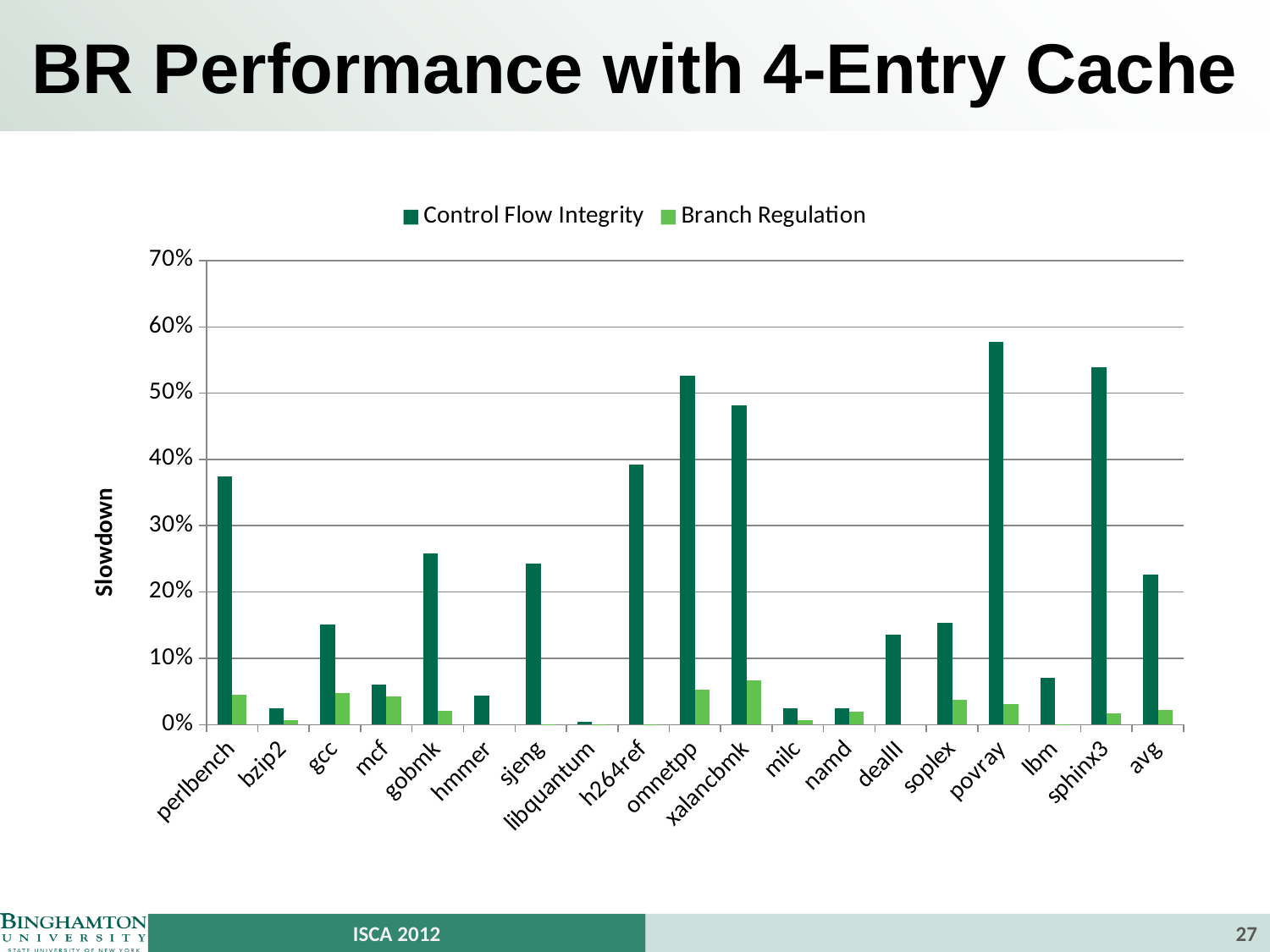
Is the Control Flow Integrity value for perlbench greater or less than 30%? greater Which is larger for omnetpp: the Control Flow Integrity slowdown or the Branch Regulation slowdown? Control Flow Integrity Which category has the highest Branch Regulation slowdown? xalancbmk Is the Control Flow Integrity value for avg greater or less than 20%? greater Which category has the lowest Control Flow Integrity slowdown? libquantum What kind of chart is shown on the slide? bar chart What is the label of the y axis? Slowdown Which category has the highest Control Flow Integrity slowdown? povray How many benchmark categories are shown on the x axis? 19 Is the Control Flow Integrity value for xalancbmk greater or less than 50%? less How many series does the legend list? 2 Which has the larger Control Flow Integrity slowdown, omnetpp or xalancbmk? omnetpp